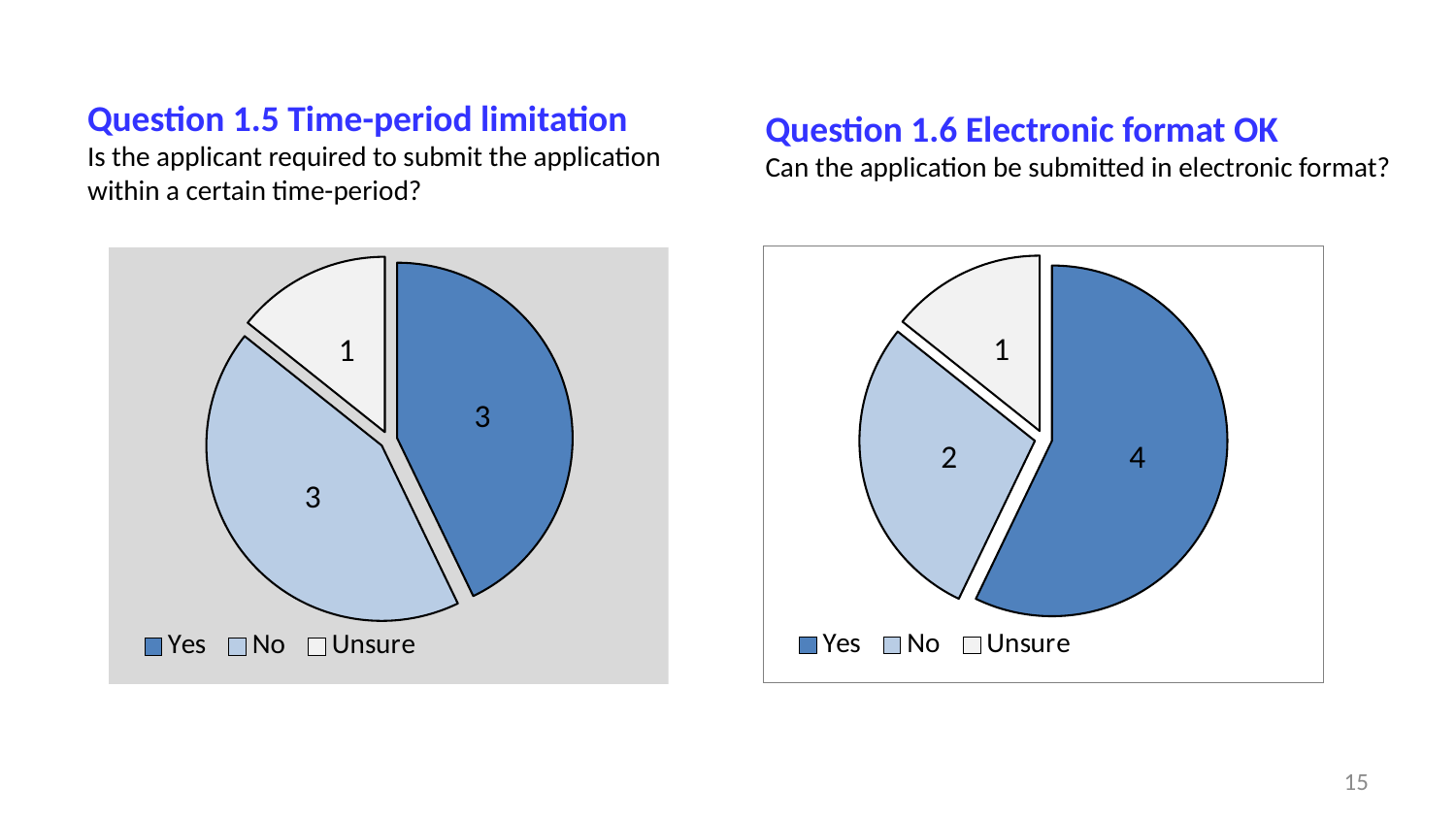
What are the legend entries in the Question 1.5 Time-period limitation chart? Yes, No, Unsure In the Question 1.5 Time-period limitation chart, which category has the smallest slice? Unsure In the Question 1.6 Electronic format OK chart, which is larger, the value for No or the value for Unsure? No In the Question 1.5 Time-period limitation chart, what is the value for Yes? 3 In the Question 1.6 Electronic format OK chart, what is the value for No? 2 How many categories does the Question 1.5 Time-period limitation chart show? 3 In the Question 1.5 Time-period limitation chart, what is the value for Unsure? 1 In the Question 1.6 Electronic format OK chart, what is the value for Yes? 4 What kind of chart is the Question 1.6 Electronic format OK chart? Pie chart In the Question 1.5 Time-period limitation chart, what is the difference between the No and Unsure values? 2 In the Question 1.6 Electronic format OK chart, which category has the largest slice? Yes In the Question 1.6 Electronic format OK chart, what is the difference between the Yes and No values? 2